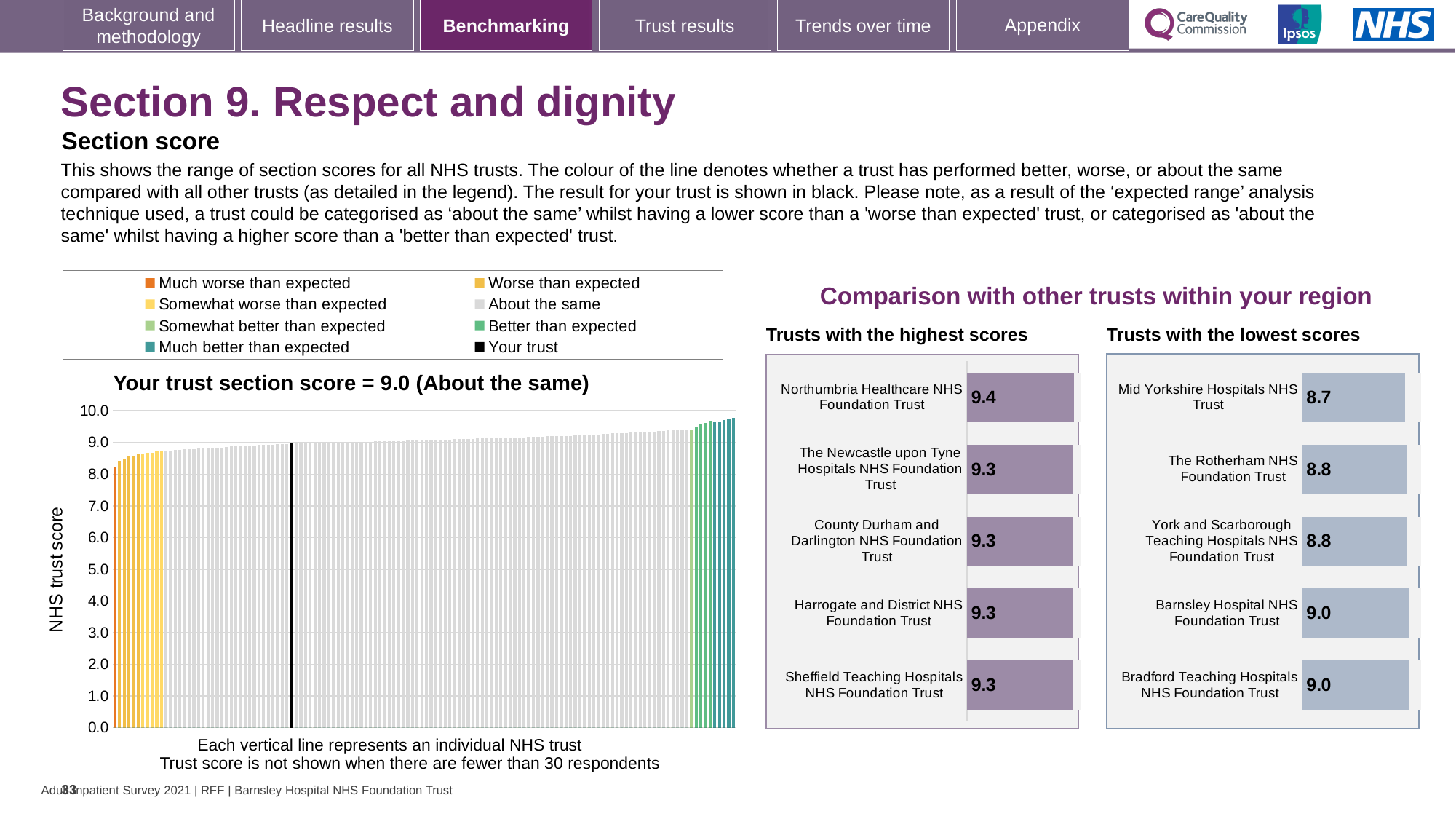
In the 'Trusts with the highest scores' chart, which trust has the highest score? Northumbria Healthcare NHS Foundation Trust In the 'Trusts with the lowest scores' chart, what is the score for Mid Yorkshire Hospitals NHS Trust? 8.7 In the 'Trusts with the lowest scores' chart, which trust has the lowest score? Mid Yorkshire Hospitals NHS Trust How many entries does the legend above the 'Your trust section score' chart list? 8 In the 'Trusts with the lowest scores' chart, which has the larger score: The Rotherham NHS Foundation Trust or Barnsley Hospital NHS Foundation Trust? Barnsley Hospital NHS Foundation Trust In the 'Trusts with the lowest scores' chart, what is the difference between the scores of Bradford Teaching Hospitals NHS Foundation Trust and Mid Yorkshire Hospitals NHS Trust? 0.3 In the 'Your trust section score' chart on the left, do the bar heights rise or fall from left to right? Rise In the 'Trusts with the highest scores' chart, what is the difference between the scores of Northumbria Healthcare NHS Foundation Trust and Sheffield Teaching Hospitals NHS Foundation Trust? 0.1 What kind of chart is the 'Your trust section score' chart on the left? Bar chart How many trusts are listed in the 'Trusts with the highest scores' chart? 5 In the 'Trusts with the highest scores' chart, what is the score for Northumbria Healthcare NHS Foundation Trust? 9.4 In the 'Trusts with the lowest scores' chart, what is the score for Barnsley Hospital NHS Foundation Trust? 9.0